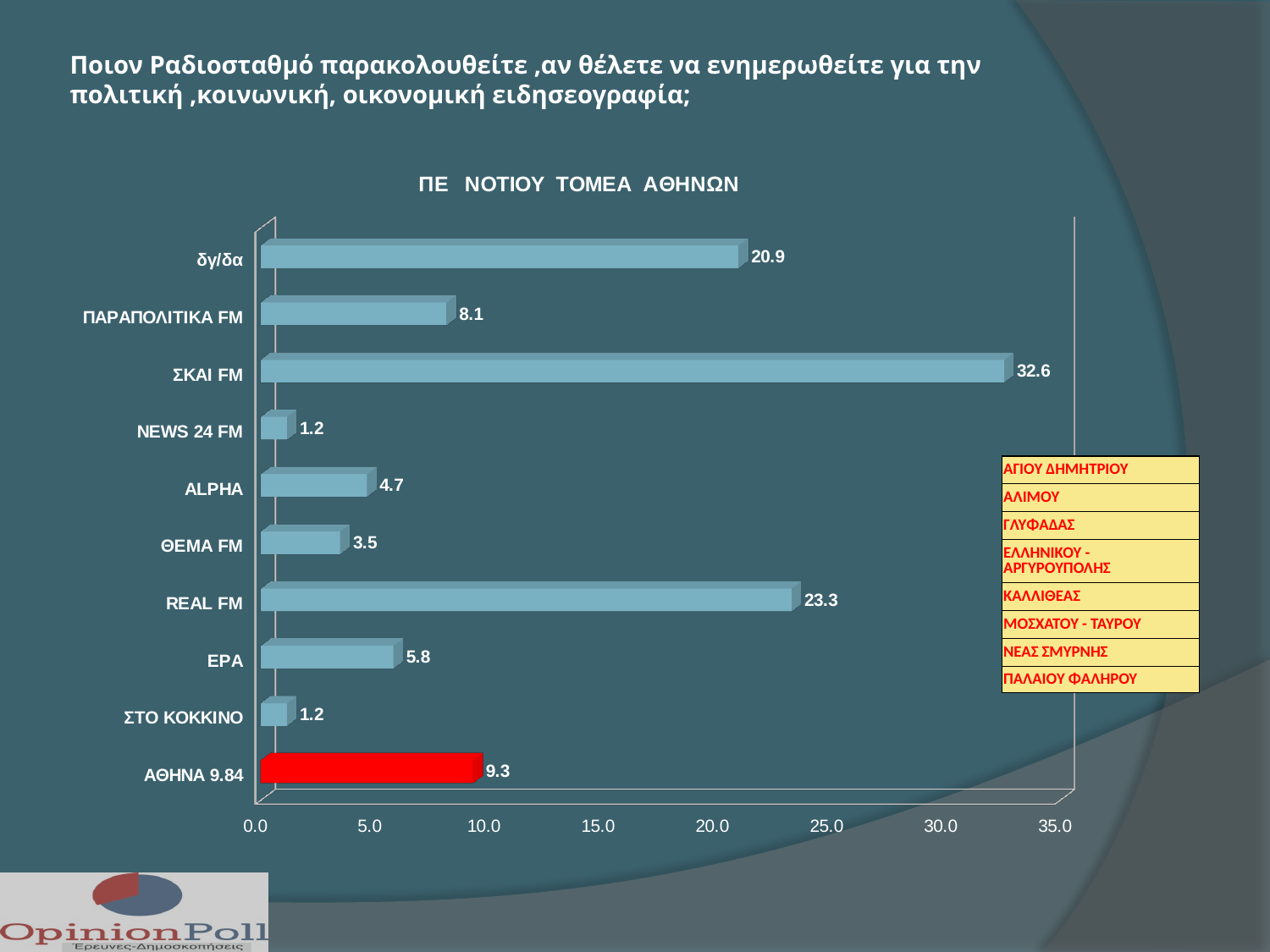
Which is larger, the value for ΠΑΡΑΠΟΛΙΤΙΚΑ FM or the value for ΕΡΑ? ΠΑΡΑΠΟΛΙΤΙΚΑ FM Which bar is coloured red? ΑΘΗΝΑ 9.84 What is the value for REAL FM? 23.3 What is the value for ΑΘΗΝΑ 9.84? 9.3 Which category has the highest value? ΣΚΑΙ FM What is the title of the chart? ΠΕ ΝΟΤΙΟΥ ΤΟΜΕΑ ΑΘΗΝΩΝ How many categories are shown on the chart? 10 What is the difference between the values for ΣΚΑΙ FM and REAL FM? 9.3 What is the value for ΣΚΑΙ FM? 32.6 What kind of chart is shown on the slide? bar chart What is the value for ALPHA? 4.7 Is the value for δγ/δα greater or less than 20.0? greater